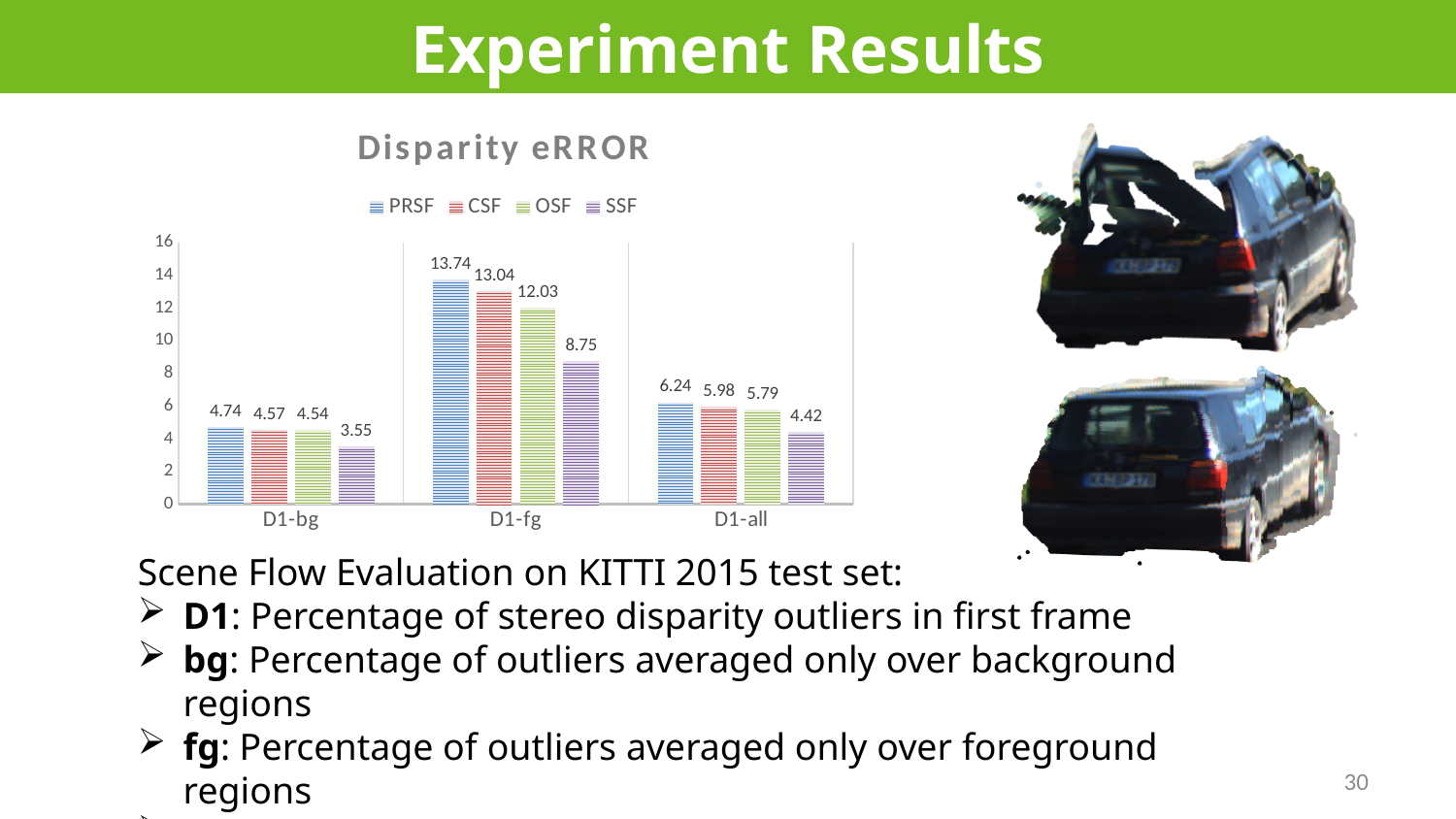
How many categories are shown on the x axis? 3 Which series has the highest value for D1-fg? PRSF Which is larger, the CSF value for D1-all or the OSF value for D1-all? CSF Which series has the lowest value for D1-all? SSF What is the OSF value for D1-all? 5.79 What is the difference between the PRSF and SSF values for D1-fg? 4.99 What is the title of the chart? Disparity eRROR How many series does the legend list? 4 What is the SSF value for D1-bg? 3.55 What is the PRSF value for D1-fg? 13.74 Is the SSF value for D1-fg greater or less than 8? greater What kind of chart is shown? bar chart